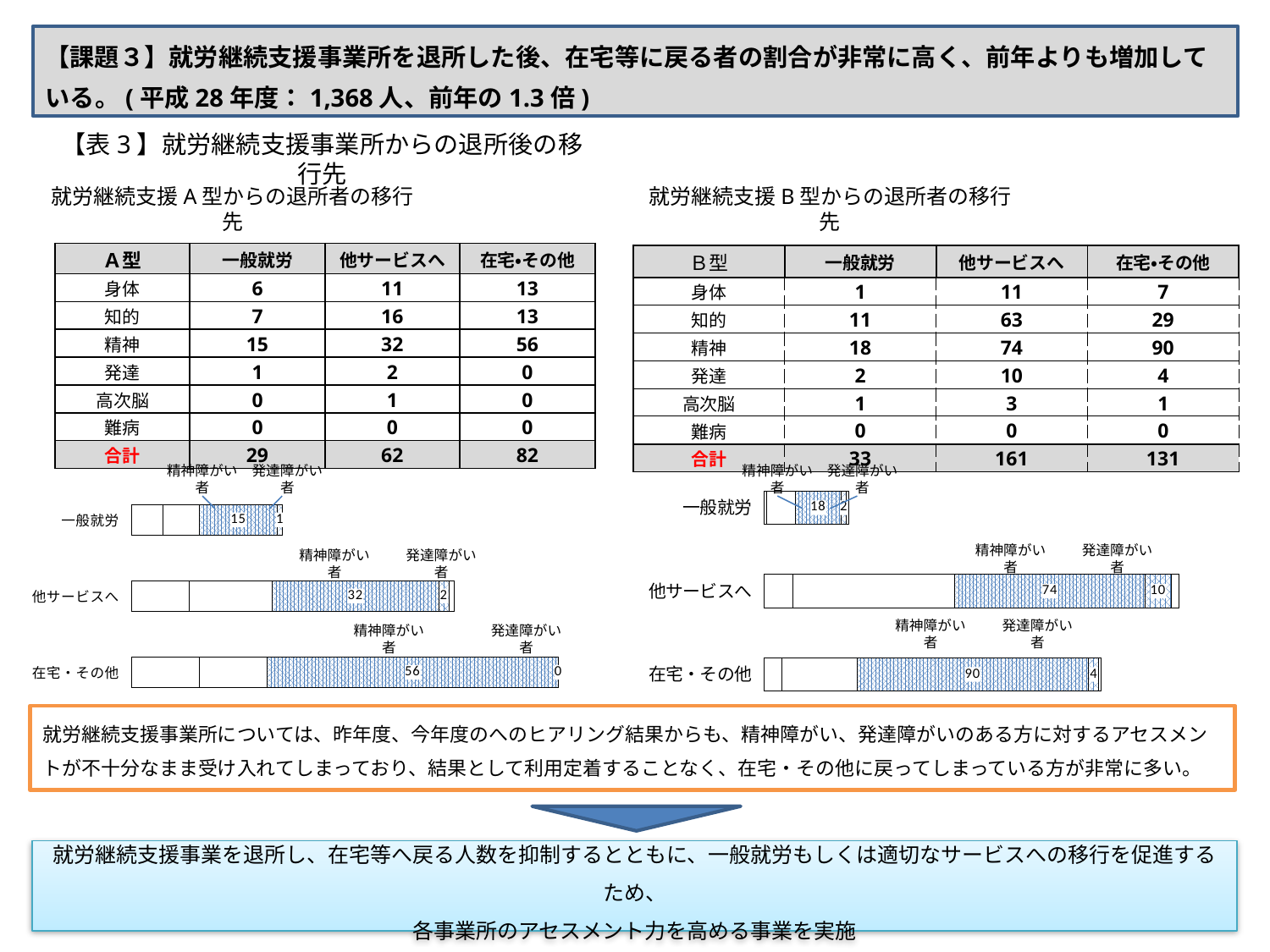
In the right chart (就労継続支援B型からの退所者の移行先), what is the labelled value for 発達障がい者 in the 在宅・その他 bar? 4 In the right chart (就労継続支援B型からの退所者の移行先), what is the labelled value for 精神障がい者 in the 他サービスへ bar? 74 In the right chart (就労継続支援B型からの退所者の移行先), which bar has the lowest labelled 精神障がい者 value? 一般就労 How many bars are shown in the left chart (就労継続支援A型からの退所者の移行先)? 3 What kind of chart is used under the B型 table on the right? Stacked bar chart In the left chart (就労継続支援A型からの退所者の移行先), what is the labelled value for 精神障がい者 in the 在宅・その他 bar? 56 In the right chart (就労継続支援B型からの退所者の移行先), what is the labelled value for 発達障がい者 in the 一般就労 bar? 2 In the left chart (就労継続支援A型からの退所者の移行先), what is the labelled value for 発達障がい者 in the 他サービスへ bar? 2 In the left chart (就労継続支援A型からの退所者の移行先), which is larger: the 精神障がい者 value for 他サービスへ or for 一般就労? 他サービスへ In the right chart (就労継続支援B型からの退所者の移行先), what is the difference between the 精神障がい者 values for 在宅・その他 and 他サービスへ? 16 In the left chart (就労継続支援A型からの退所者の移行先), what is the labelled value for 精神障がい者 in the 一般就労 bar? 15 In the left chart (就労継続支援A型からの退所者の移行先), which bar has the highest labelled 精神障がい者 value? 在宅・その他